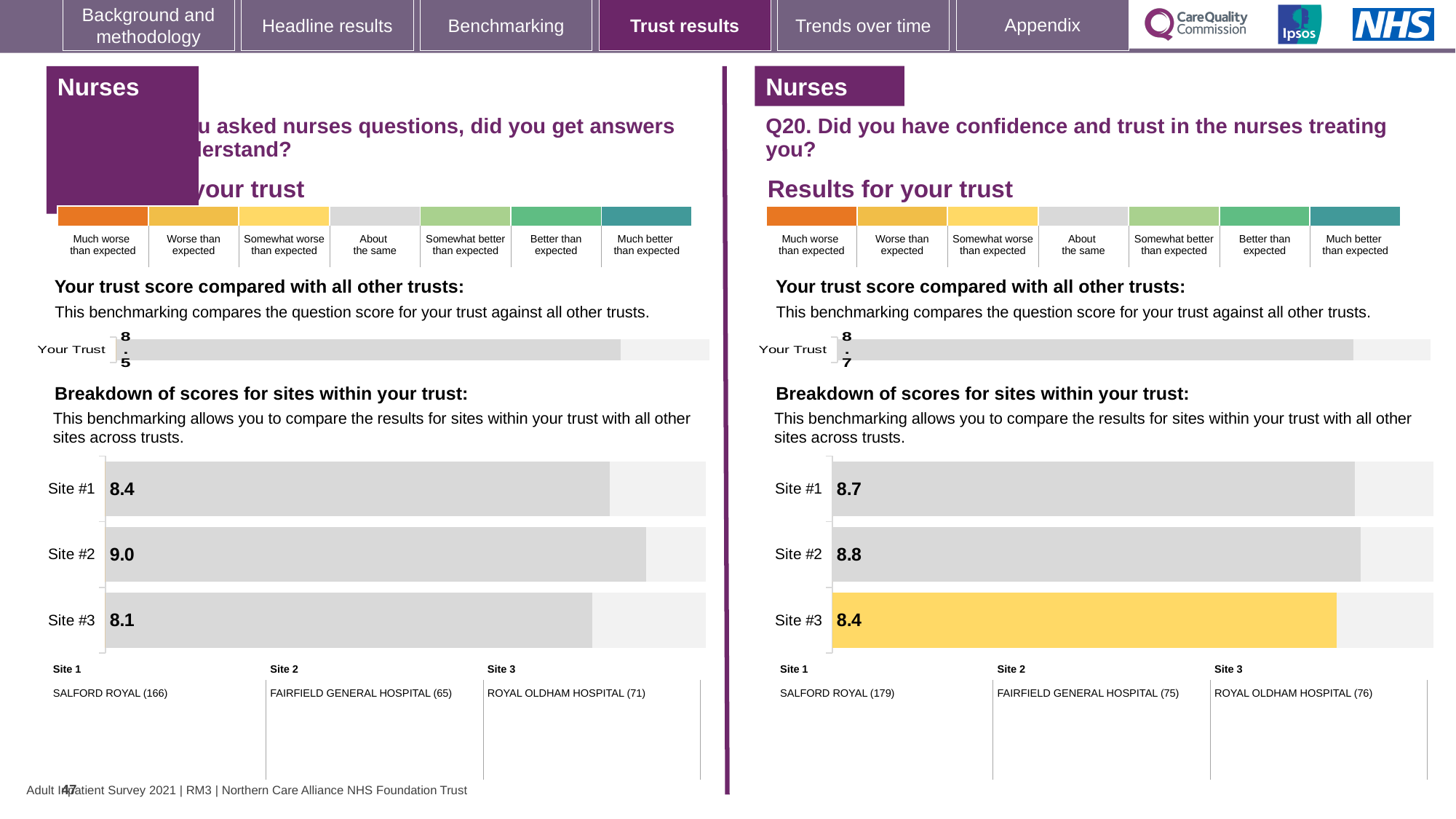
How many sites are shown on the right-hand (Q20) site breakdown chart? 3 On the left-hand 'Your trust score compared with all other trusts' chart, what is the score for Your Trust? 8.5 On the left-hand site breakdown chart, what is the score for Site #2? 9.0 What type of chart is used for the site breakdown of scores on the slide? Bar chart On the left-hand site breakdown chart, which site has the lowest score? Site #3 Which is larger: the Site #1 score on the left-hand site breakdown chart or the Site #1 score on the right-hand (Q20) site breakdown chart? Right-hand (Q20) chart, 8.7 On the left-hand site breakdown chart, which site has the highest score? Site #2 On the right-hand (Q20) 'Your trust score compared with all other trusts' chart, what is the score for Your Trust? 8.7 On the right-hand (Q20) site breakdown chart, what is the score for Site #3? 8.4 On the right-hand (Q20) site breakdown chart, what is the difference between the scores for Site #2 and Site #3? 0.4 On the left-hand site breakdown chart, what is the difference between the scores for Site #2 and Site #3? 0.9 On the right-hand (Q20) site breakdown chart, which site has the lowest score? Site #3